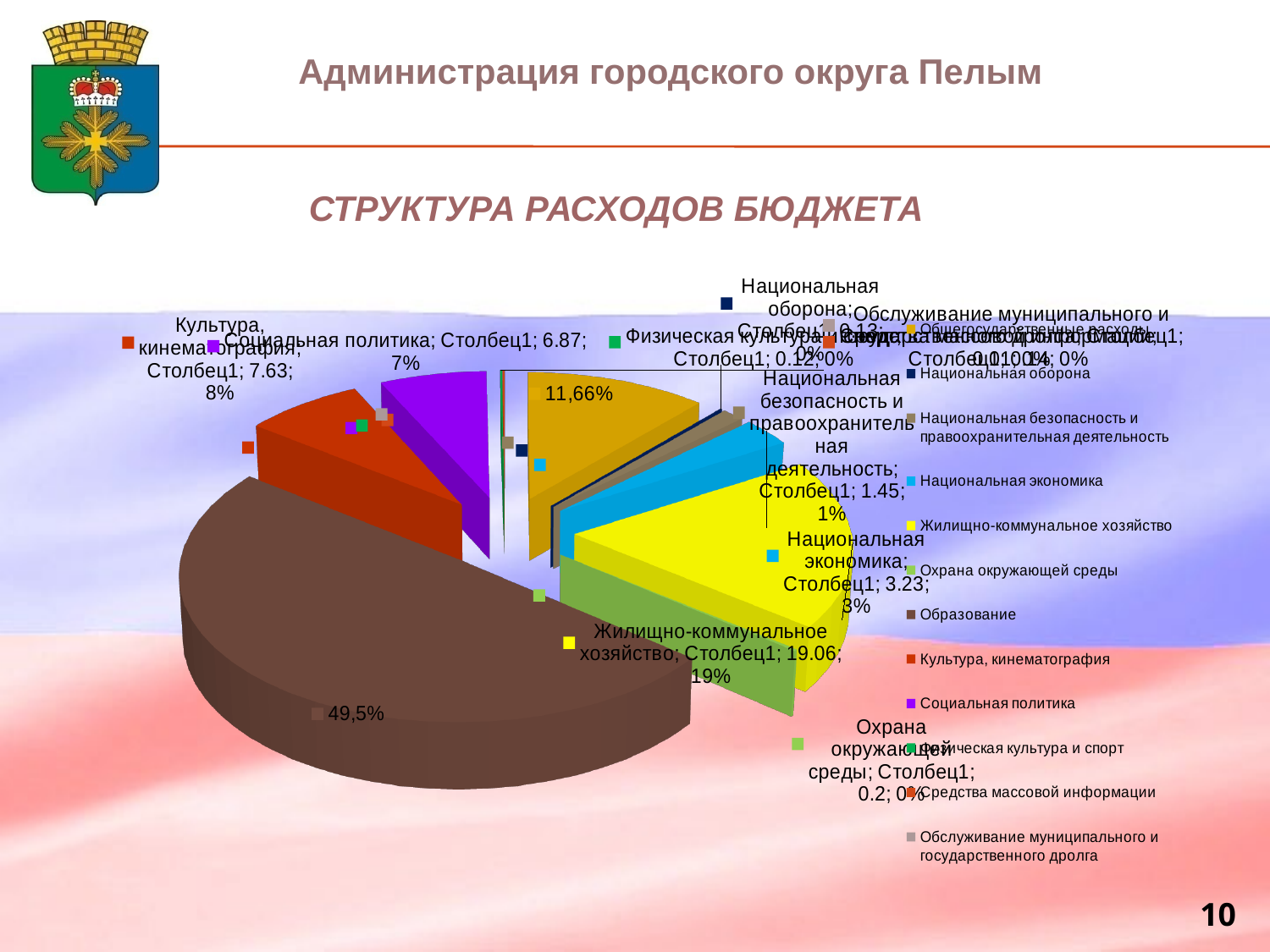
What percentage share is shown on the largest slice of the pie? 49,5% What value is shown for Культура, кинематография? 7.63 How many categories does the chart legend list? 12 What value is shown for Социальная политика? 6.87 What percentage share of the pie does Жилищно-коммунальное хозяйство have? 19% What value is shown for Жилищно-коммунальное хозяйство? 19.06 What is the title of the chart on the slide? СТРУКТУРА РАСХОДОВ БЮДЖЕТА Which is larger, the value for Жилищно-коммунальное хозяйство or the value for Социальная политика? Жилищно-коммунальное хозяйство What value is shown for Национальная безопасность и правоохранительная деятельность? 1.45 What value is shown for Национальная экономика? 3.23 What is the difference between the values for Жилищно-коммунальное хозяйство and Социальная политика? 12.19 What kind of chart is shown on the slide? pie chart